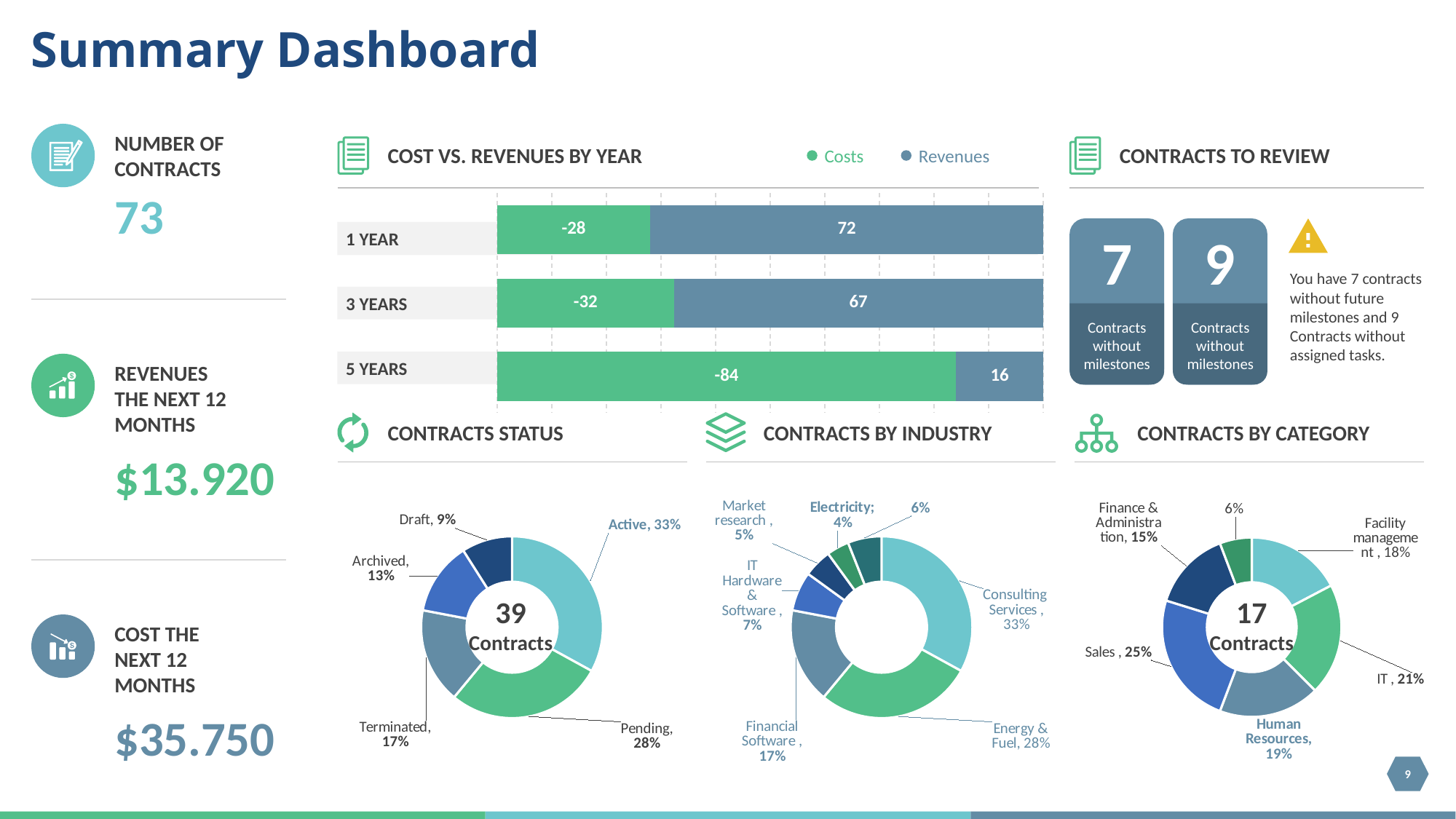
In the Cost vs. Revenues by Year chart, what is the difference between the Revenues for 1 YEAR and 3 YEARS? 5 How many slices does the Contracts Status chart have? 5 In the Contracts Status chart, what share is Active? 33% In the Contracts Status chart, which status has the smallest share? Draft In the Cost vs. Revenues by Year chart, what is the Revenues value for 1 YEAR? 72 What kind of chart is the Cost vs. Revenues by Year chart? Bar chart In the Cost vs. Revenues by Year chart, do the Revenues values rise or fall from 1 YEAR to 5 YEARS? Fall In the Cost vs. Revenues by Year chart, which year has the highest Revenues value? 1 YEAR In the Cost vs. Revenues by Year chart, what is the Costs value for 5 YEARS? -84 In the Contracts by Industry chart, what share is Energy & Fuel? 28% In the Contracts by Category chart, which category has the largest share? Sales How many series does the legend of the Cost vs. Revenues by Year chart list? 2